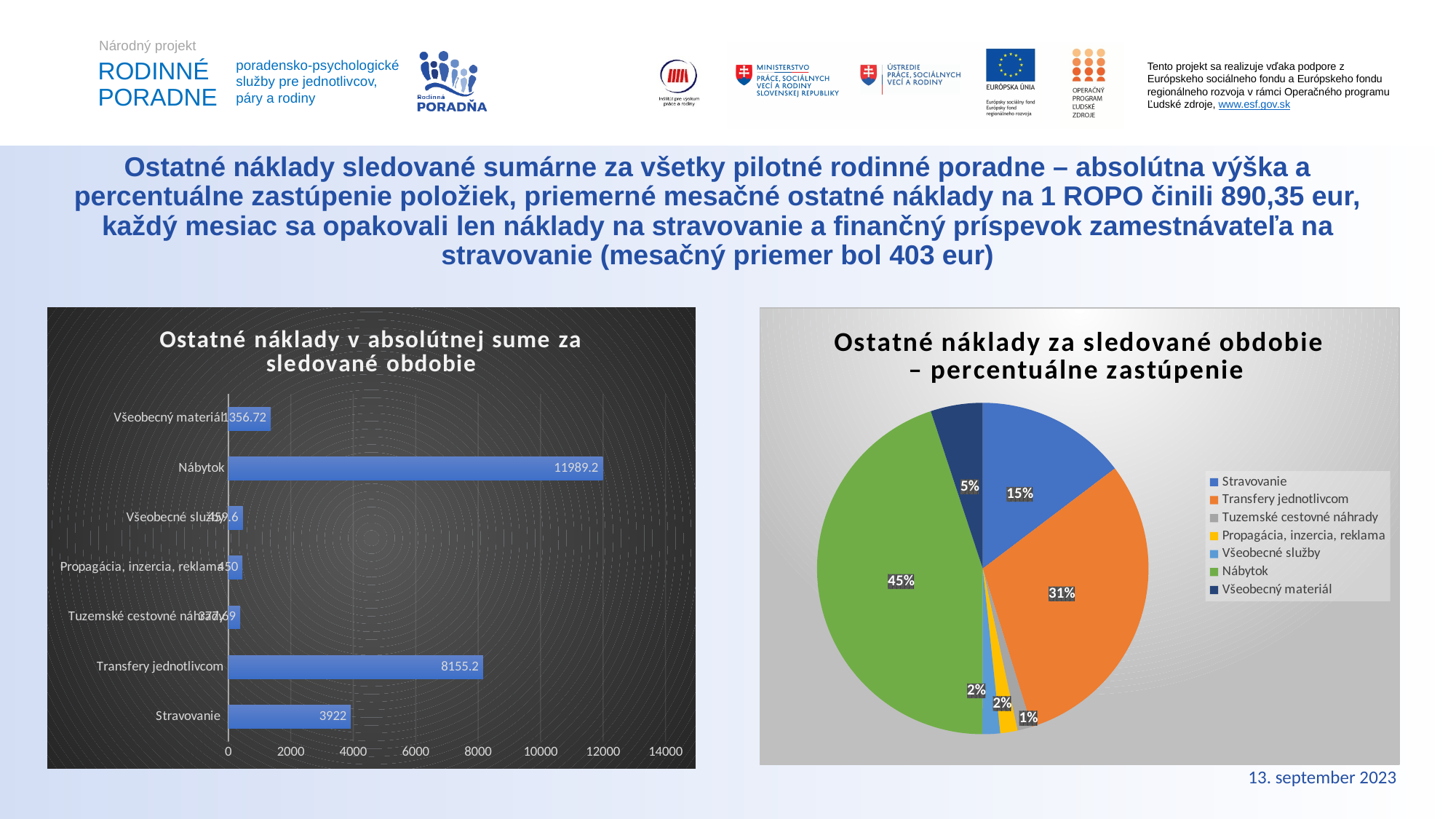
In the left chart 'Ostatné náklady v absolútnej sume za sledované obdobie', what is the value for Nábytok? 11989.2 In the left chart 'Ostatné náklady v absolútnej sume za sledované obdobie', is the value for Všeobecný materiál greater or less than 2000? less In the left chart 'Ostatné náklady v absolútnej sume za sledované obdobie', what is the value for Transfery jednotlivcom? 8155.2 How many categories are shown in the left chart 'Ostatné náklady v absolútnej sume za sledované obdobie'? 7 In the right pie chart 'Ostatné náklady za sledované obdobie – percentuálne zastúpenie', what share does Transfery jednotlivcom have? 31% In the left chart 'Ostatné náklady v absolútnej sume za sledované obdobie', which category has the highest value? Nábytok How many entries does the legend of the right pie chart 'Ostatné náklady za sledované obdobie – percentuálne zastúpenie' list? 7 In the right pie chart 'Ostatné náklady za sledované obdobie – percentuálne zastúpenie', which is larger: Stravovanie or Všeobecný materiál? Stravovanie In the left chart 'Ostatné náklady v absolútnej sume za sledované obdobie', what is the value for Stravovanie? 3922 What kind of chart is the left chart titled 'Ostatné náklady v absolútnej sume za sledované obdobie'? bar chart In the right pie chart 'Ostatné náklady za sledované obdobie – percentuálne zastúpenie', what share does Nábytok have? 45% In the left chart 'Ostatné náklady v absolútnej sume za sledované obdobie', what is the difference between the values for Nábytok and Transfery jednotlivcom? 3834